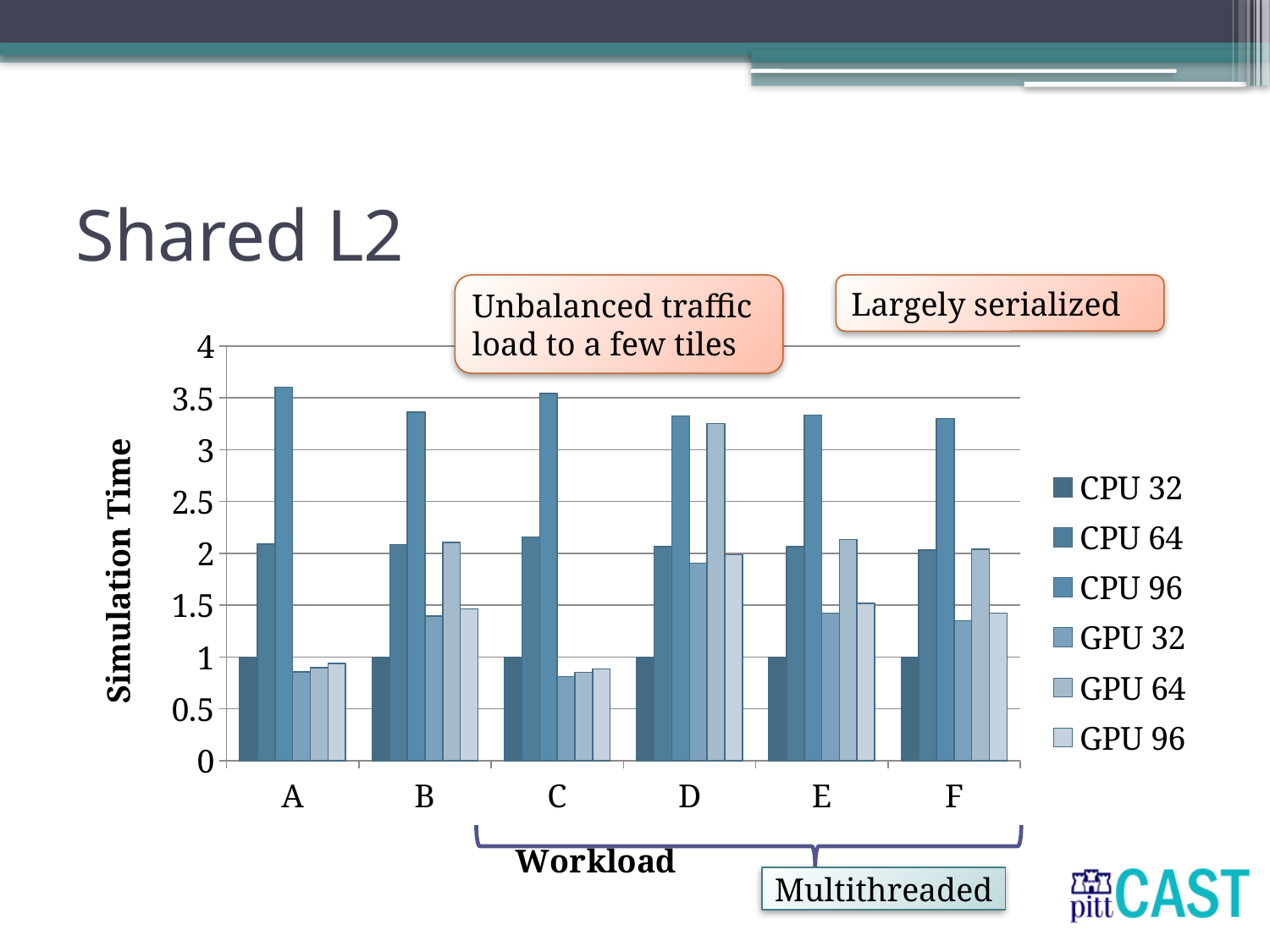
How many series does the legend list? 6 Is the value for CPU 96 on workload B greater or less than 3.5? less For workload B, which is larger: CPU 96 or CPU 64? CPU 96 What is the title of the y axis? Simulation Time Is the value for GPU 32 on workload C greater or less than 1? less What is the Simulation Time value for CPU 32 on workload F? 1 What is the Simulation Time value for CPU 32 on workload A? 1 How many workload categories are shown on the x axis? 6 Is the value for GPU 64 on workload D greater or less than 3? greater Which series has the highest Simulation Time for workload A? CPU 96 What kind of chart is shown on the slide? bar chart